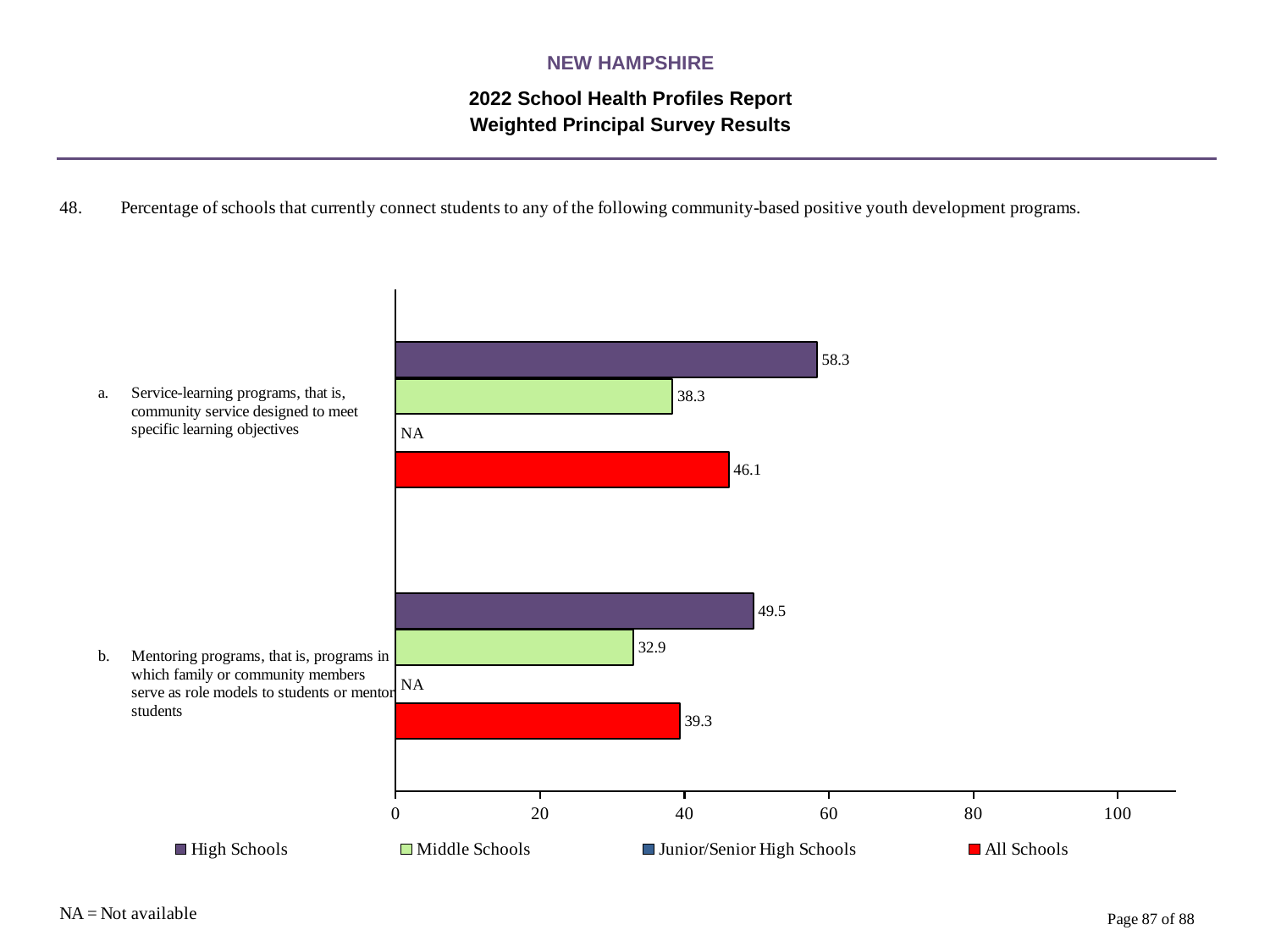
What is the difference between the High Schools and Middle Schools values for service-learning programs (item a)? 20 What colour are the All Schools bars? red What value is shown for Junior/Senior High Schools for mentoring programs (item b)? NA What is the value for High Schools for service-learning programs (item a)? 58.3 What is the value for Middle Schools for mentoring programs (item b)? 32.9 What is the difference between the All Schools values for item a and item b? 6.8 Which is larger: the High Schools value for item a or the High Schools value for item b? item a Which school type has the lowest plotted value for service-learning programs (item a)? Middle Schools Which school type has the highest value for mentoring programs (item b)? High Schools What is the value for All Schools for service-learning programs (item a)? 46.1 What kind of chart is shown on the slide? bar chart How many series does the legend list? 4